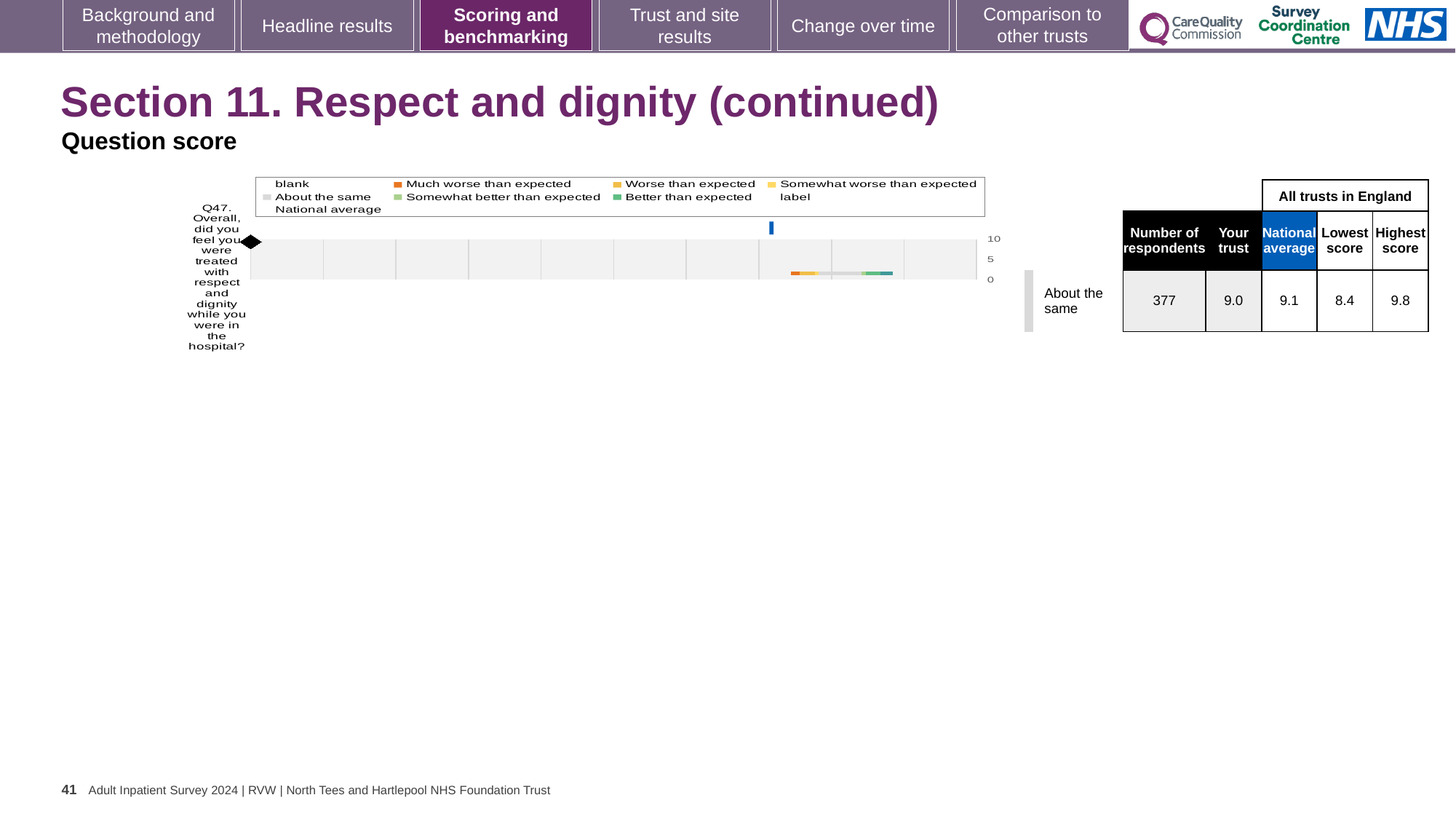
How many respondents answered Q47? 377 What is the 'Your trust' score for Q47? 9.0 What is the highest value shown on the chart's score axis? 10 What is the national average score for Q47? 9.1 What is the difference between the highest score and the lowest score for Q47? 1.4 How many questions are plotted on the chart? 1 What is the lowest score among all trusts in England for Q47? 8.4 Is the 'Your trust' score for Q47 higher or lower than the national average? lower What kind of chart is used to show the Q47 question score? bar chart How many entries does the chart legend list? 9 Which benchmarking category is the trust placed in for Q47? About the same What is the highest score among all trusts in England for Q47? 9.8